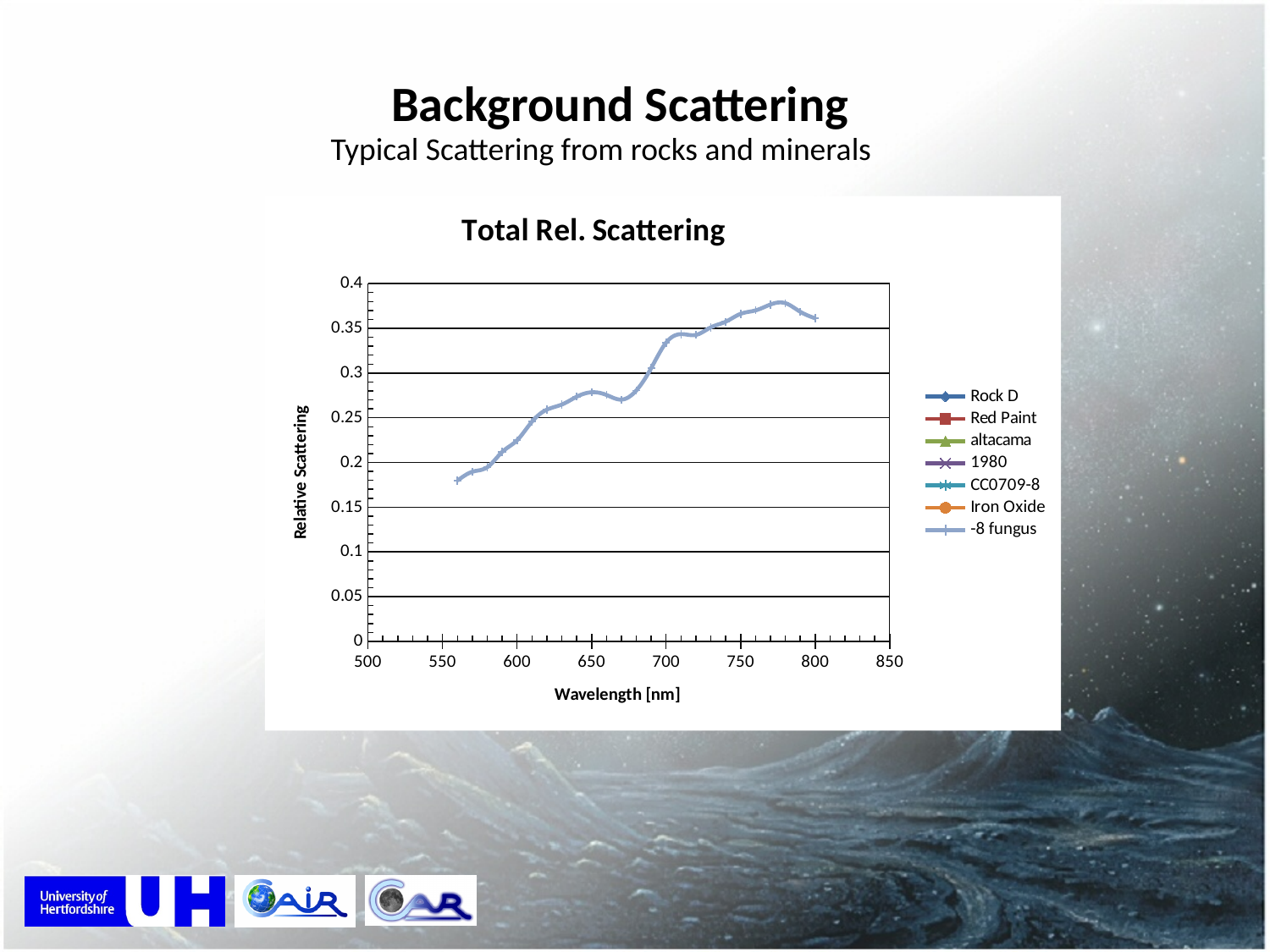
What is the title of the chart? Total Rel. Scattering Does the plotted line generally rise or fall as the wavelength increases from 550 nm to 750 nm? rise Is the plotted value at a wavelength of 650 nm greater or less than 0.25? greater Is the plotted value at 700 nm larger or smaller than the value at 600 nm? larger How many series does the legend of the chart list? 7 What kind of chart is shown on the slide? line chart Is the plotted value at a wavelength of 700 nm greater or less than 0.3? greater Is the plotted value at a wavelength of 600 nm greater or less than 0.25? less What is the label of the x axis of the chart? Wavelength [nm]